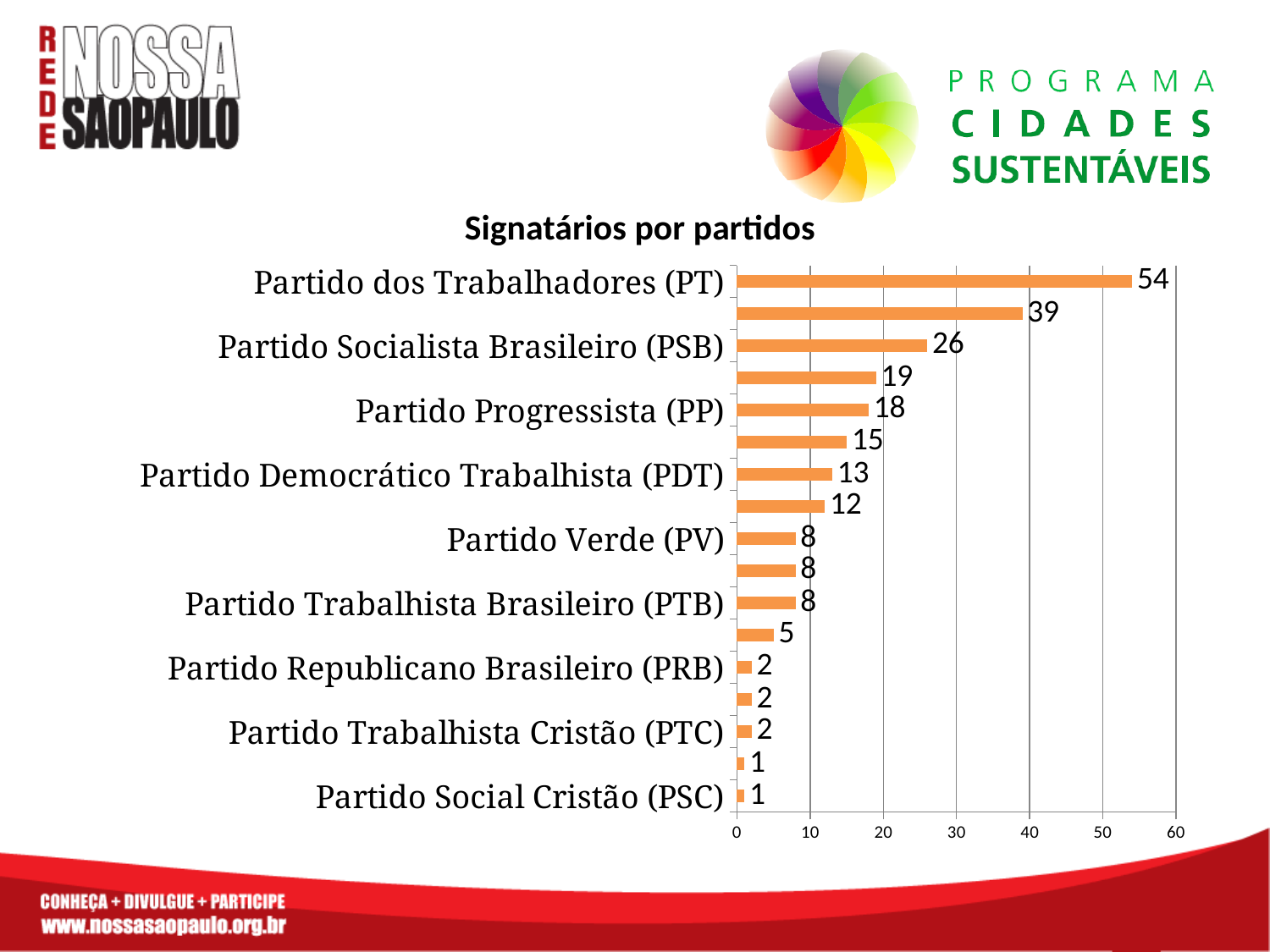
What is the value for Partido Democrático Trabalhista (PDT)? 13 What is the value for Partido Verde (PV)? 8 What is the title of the chart? Signatários por partidos Which party has the highest number of signatories? Partido dos Trabalhadores (PT) What is the difference between the values for Partido dos Trabalhadores (PT) and Partido Socialista Brasileiro (PSB)? 28 What is the value for Partido Socialista Brasileiro (PSB)? 26 What kind of chart is shown on the slide? Bar chart How many signatories does Partido dos Trabalhadores (PT) have? 54 What is the value for Partido Progressista (PP)? 18 What is the value for Partido Social Cristão (PSC)? 1 Which has a larger value, Partido Progressista (PP) or Partido Democrático Trabalhista (PDT)? Partido Progressista (PP) How many bars are plotted in the chart? 17